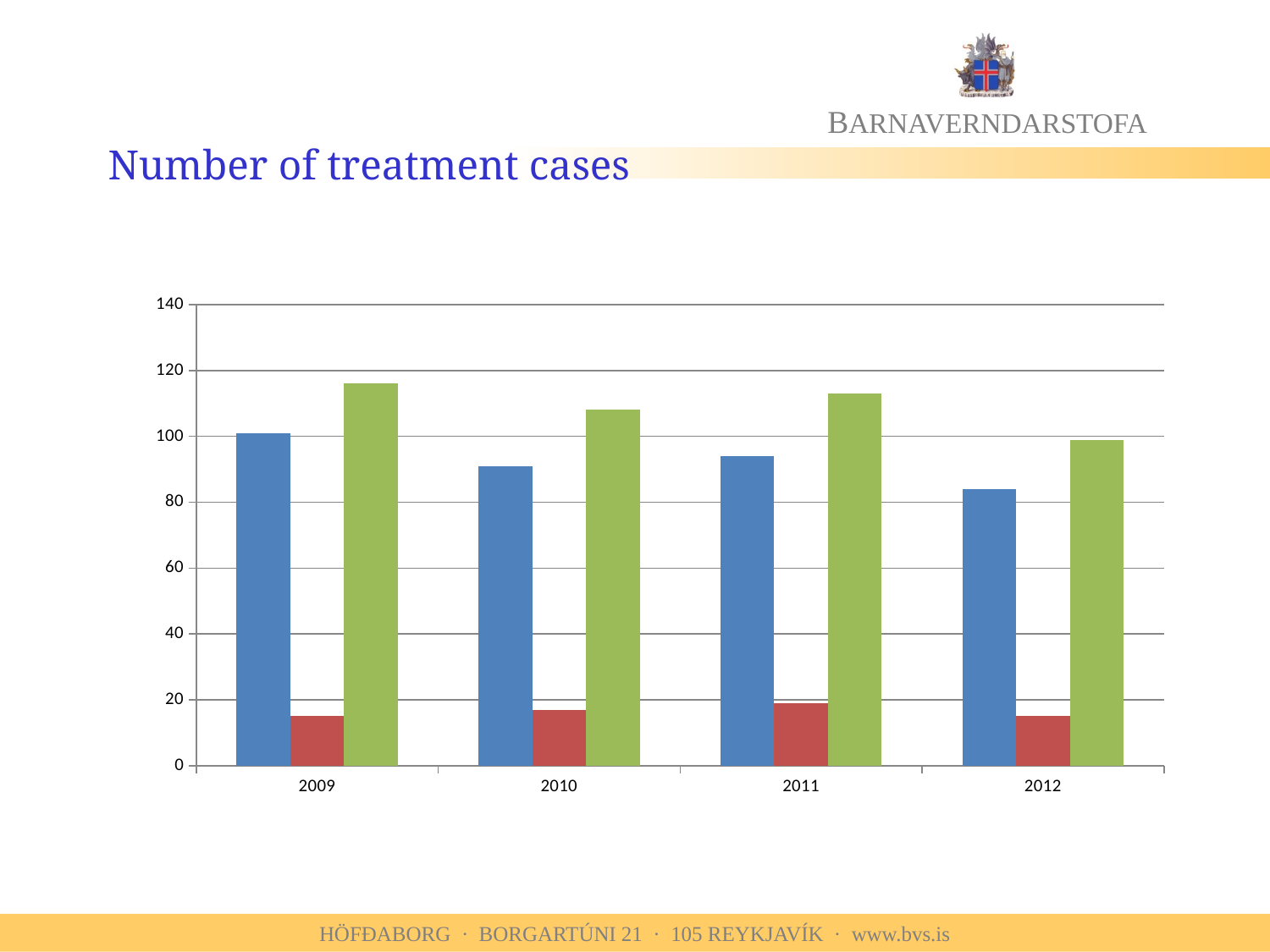
In which year is the green bar the tallest? 2009 Is the value of the red bar for 2009 greater or less than 20? less What is the title of the slide containing the chart? Number of treatment cases Which colour of bar is the shortest in every year shown? red Is the value of the green bar for 2009 greater or less than 100? greater In which year is the blue bar the shortest? 2012 What kind of chart is shown on the slide? bar chart How many years are shown on the x axis of the chart? 4 Is the value of the green bar for 2010 greater or less than 100? greater How many bars are plotted for each year in the chart? 3 In 2011, which is larger, the blue bar or the green bar? the green bar